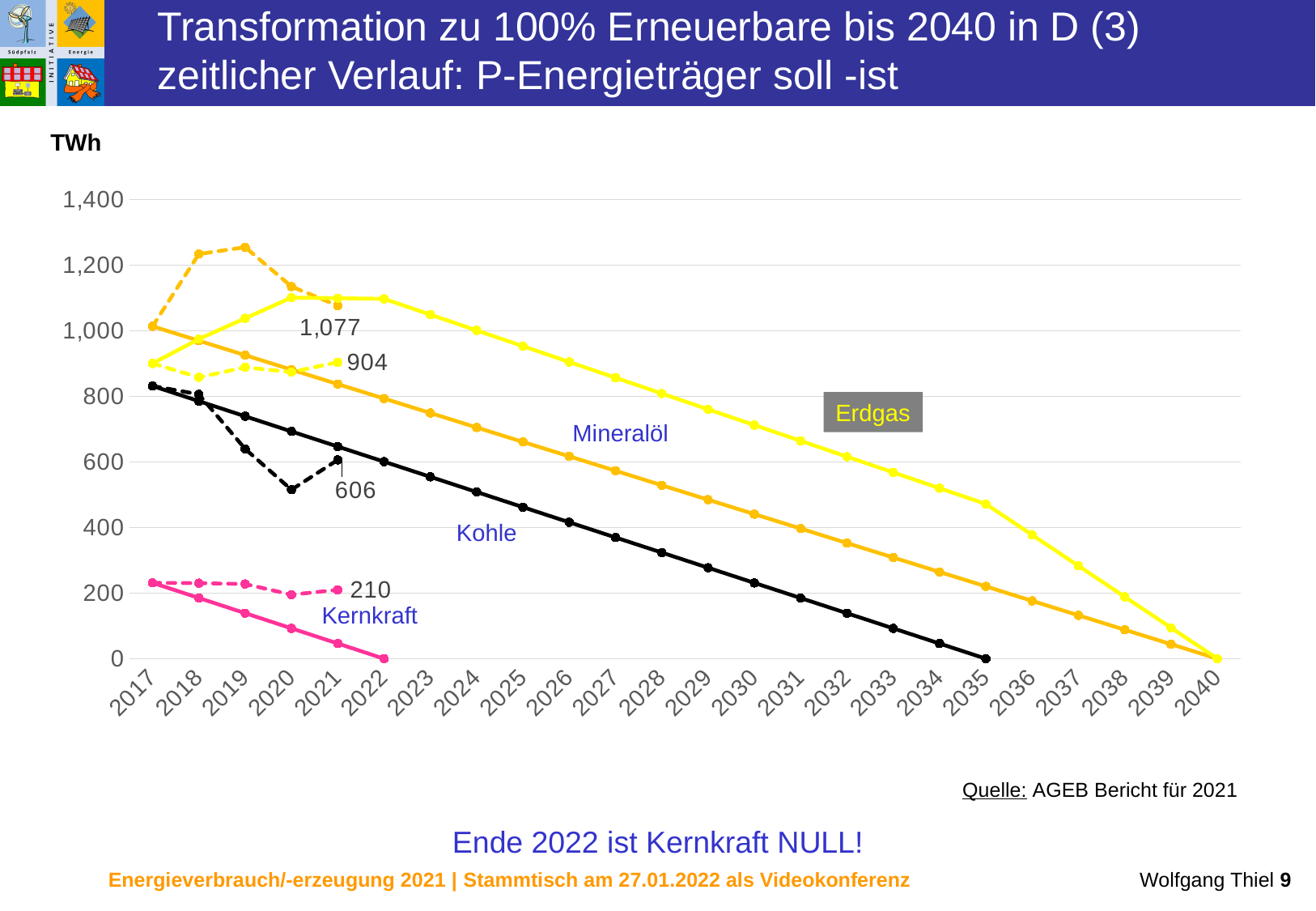
Is the value of the Erdgas line in 2030 greater or less than 600? greater Which energy source has the lowest labelled 2021 value? Kernkraft What is the labelled 2021 value for Erdgas? 904 What is the labelled 2021 value for Kernkraft? 210 What is the labelled 2021 value for Mineralöl? 1,077 In which year does the solid Kohle line reach 0? 2035 What kind of chart is shown on the slide? line chart Which is larger, the labelled 2021 value for Kohle or for Kernkraft? Kohle What is the difference between the labelled 2021 values for Mineralöl and Erdgas? 173 What unit is shown on the y axis? TWh What is the labelled 2021 value for Kohle? 606 Which energy source has the highest labelled 2021 value? Mineralöl